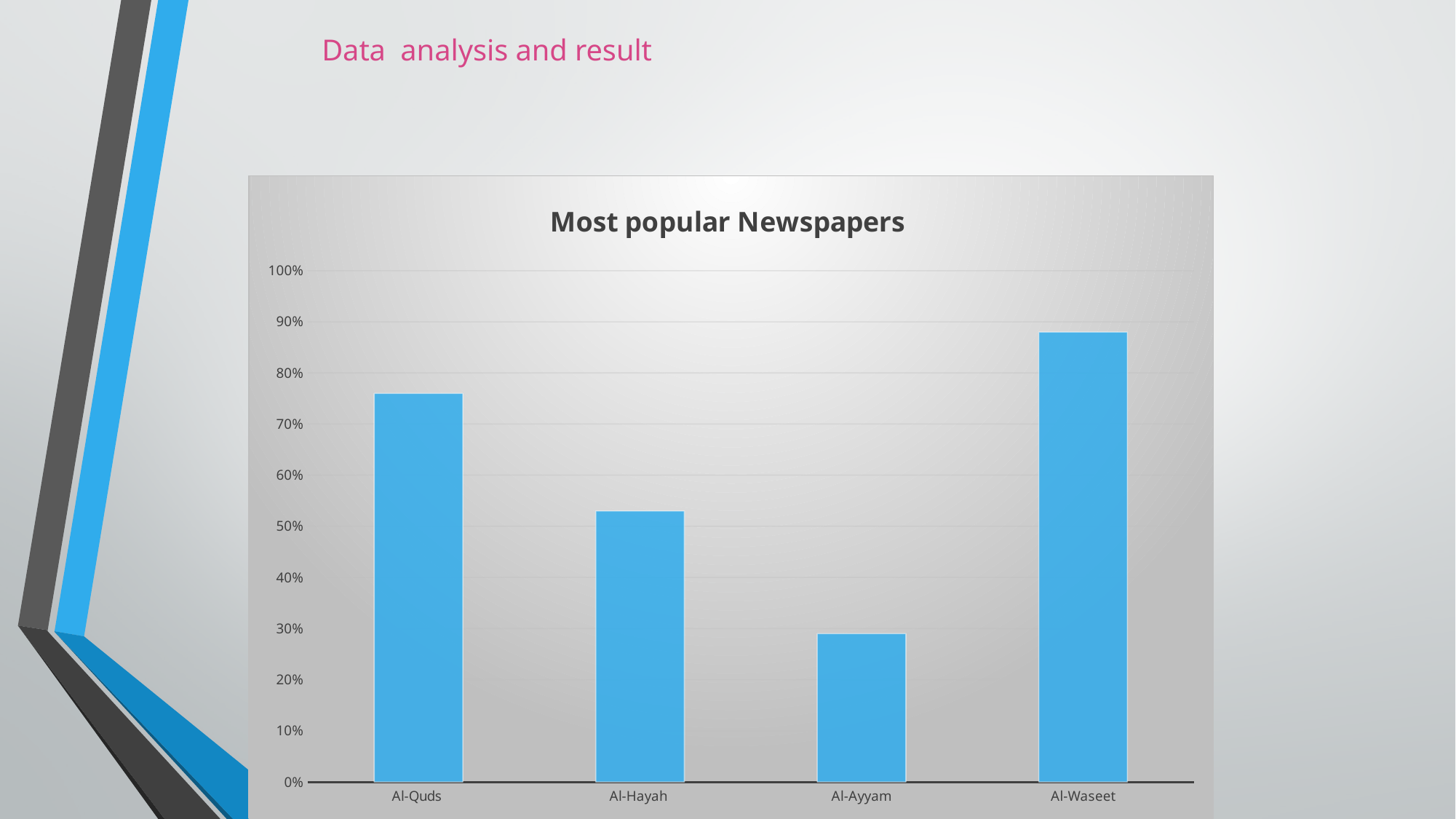
What colour are the bars in the chart? blue Is the value for Al-Quds greater or less than 70%? greater Is the value for Al-Ayyam greater or less than 40%? less Which newspaper has the lowest value in the chart? Al-Ayyam Which newspaper has the highest value in the chart? Al-Waseet Which has a larger value, Al-Quds or Al-Hayah? Al-Quds What kind of chart is shown on the slide? bar chart Which has a larger value, Al-Ayyam or Al-Waseet? Al-Waseet What is the title of the chart? Most popular Newspapers Is the value for Al-Hayah greater or less than 60%? less How many newspapers are shown on the x axis of the chart? 4